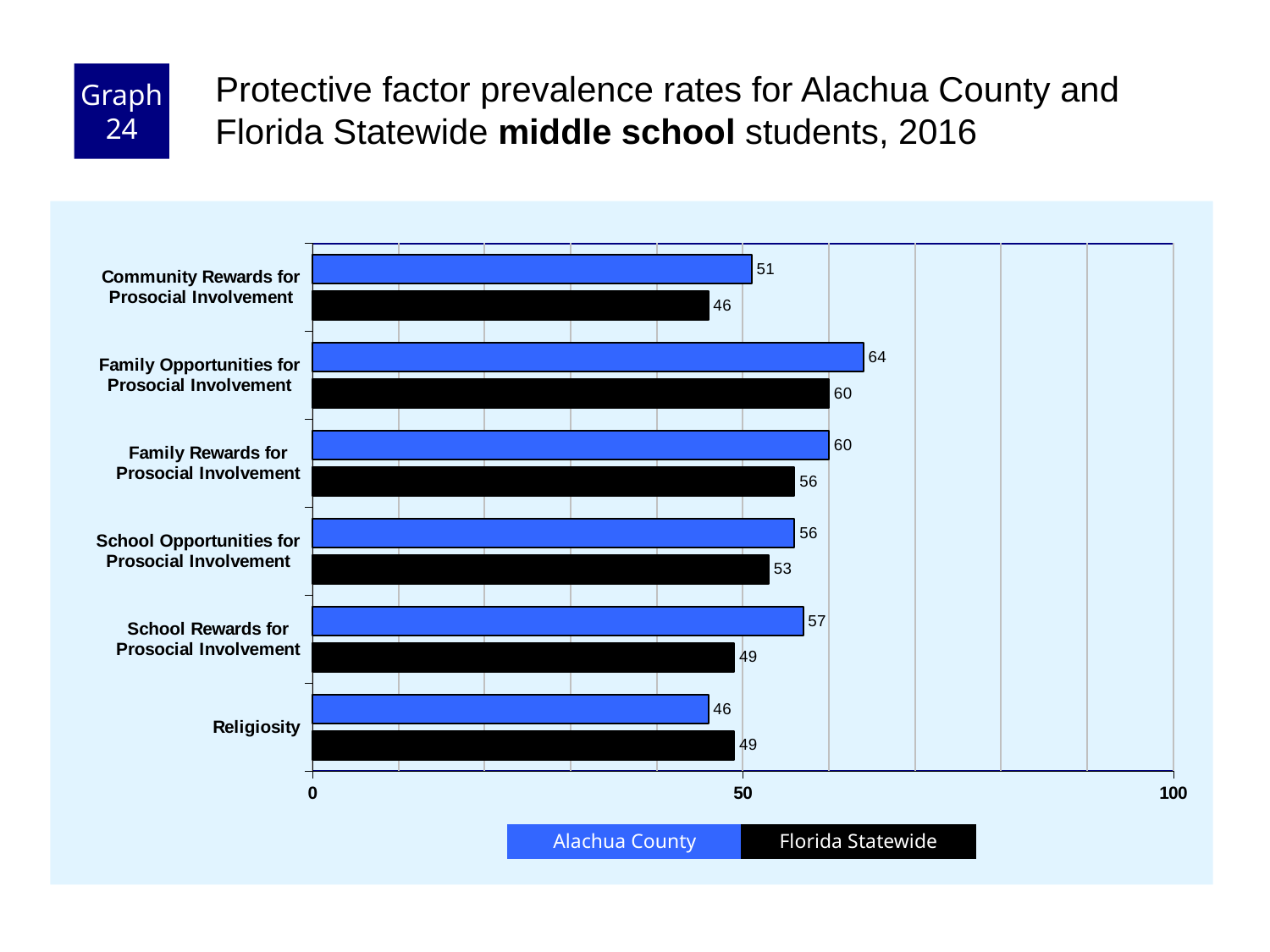
How many series does the legend list? 2 Which category has the highest Alachua County value? Family Opportunities for Prosocial Involvement Which category has the lowest Alachua County value? Religiosity What is the Alachua County value for Family Opportunities for Prosocial Involvement? 64 How many categories are shown on the chart? 6 What is the Florida Statewide value for School Rewards for Prosocial Involvement? 49 What is the Florida Statewide value for Religiosity? 49 Is the Florida Statewide value for Family Opportunities for Prosocial Involvement greater or less than 50? greater Which category has the lowest Florida Statewide value? Community Rewards for Prosocial Involvement For Religiosity, which is larger: the Alachua County value or the Florida Statewide value? Florida Statewide What is the difference between the Alachua County and Florida Statewide values for School Rewards for Prosocial Involvement? 8 What kind of chart is shown on the slide? bar chart